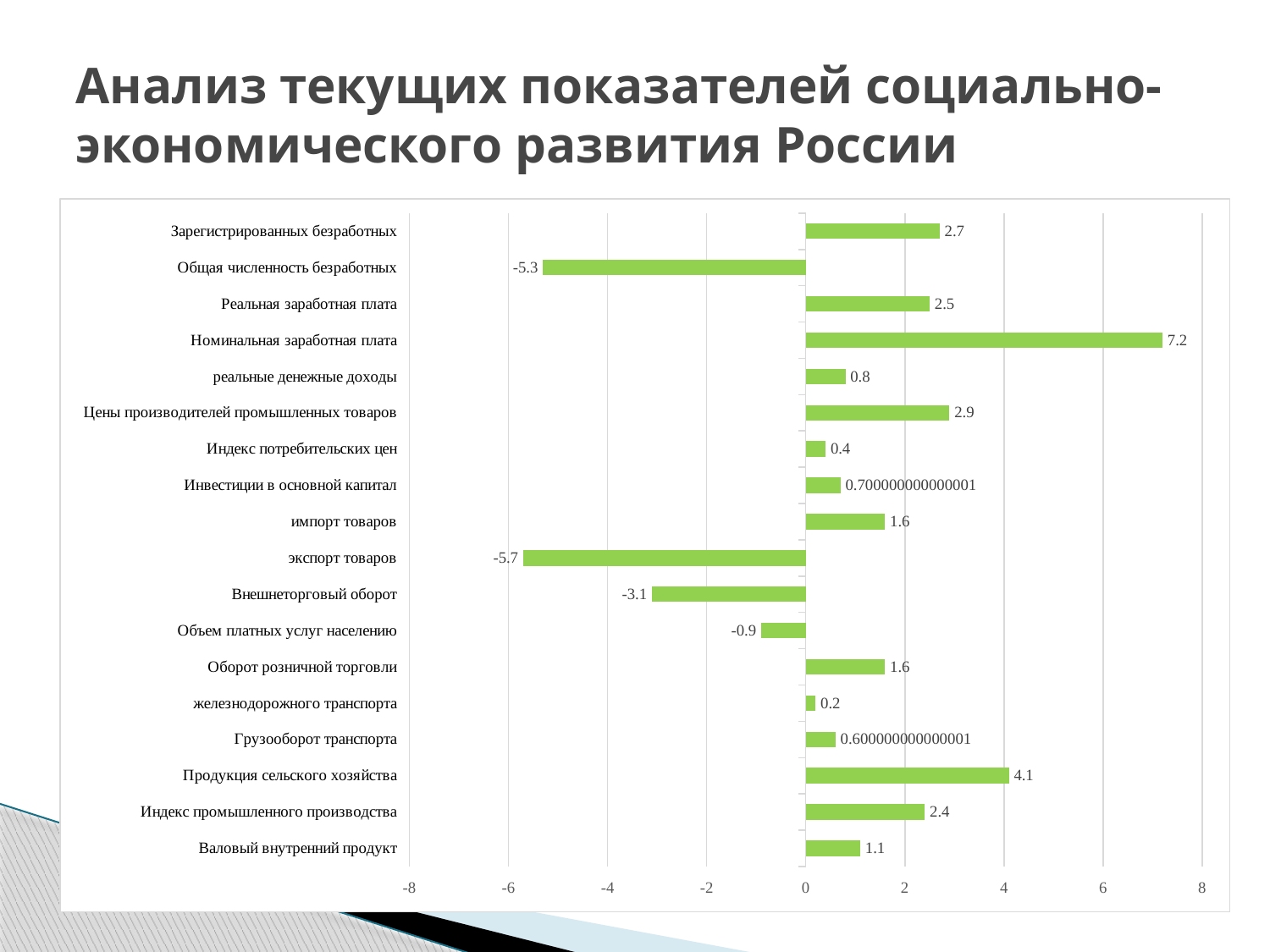
What is the difference between the values for Номинальная заработная плата and Продукция сельского хозяйства? 3.1 What value is shown for экспорт товаров? -5.7 What value is shown for Продукция сельского хозяйства? 4.1 What value is shown for Внешнеторговый оборот? -3.1 Which is larger: the value for Продукция сельского хозяйства or the value for Цены производителей промышленных товаров? Продукция сельского хозяйства How many categories are plotted in the chart? 18 Which category has the highest value? Номинальная заработная плата What kind of chart is shown on the slide? bar chart What value is shown for Номинальная заработная плата? 7.2 Is the value for Номинальная заработная плата greater or less than 6? greater What value is shown for Валовый внутренний продукт? 1.1 Which category has the lowest value? экспорт товаров